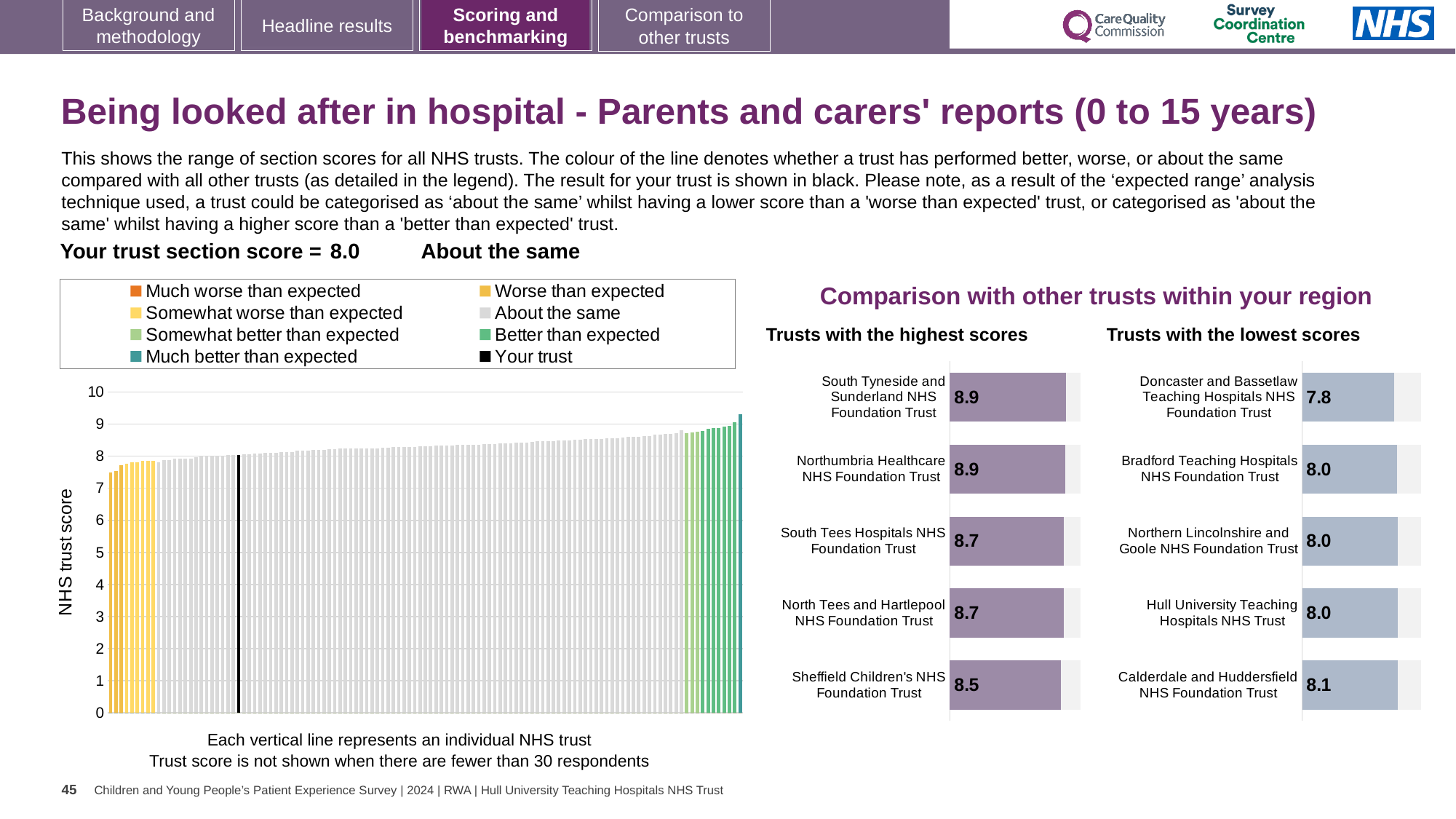
In the main chart on the left, do the trust scores rise or fall from left to right? Rise In the 'Trusts with the highest scores' chart, which trust has the lowest score? Sheffield Children's NHS Foundation Trust In the 'Trusts with the highest scores' chart, which has the higher score: South Tees Hospitals NHS Foundation Trust or Sheffield Children's NHS Foundation Trust? South Tees Hospitals NHS Foundation Trust How many entries does the legend of the main chart on the left list? 8 In the 'Trusts with the lowest scores' chart, which trust has the lowest score? Doncaster and Bassetlaw Teaching Hospitals NHS Foundation Trust In the 'Trusts with the highest scores' chart, what is the score for South Tees Hospitals NHS Foundation Trust? 8.7 How many trusts are shown in the 'Trusts with the highest scores' chart? 5 In the 'Trusts with the lowest scores' chart, which trust has the highest score? Calderdale and Huddersfield NHS Foundation Trust In the 'Trusts with the lowest scores' chart, how much higher is Calderdale and Huddersfield NHS Foundation Trust's score than Doncaster and Bassetlaw Teaching Hospitals NHS Foundation Trust's score? 0.3 In the 'Trusts with the lowest scores' chart, what is the score for Doncaster and Bassetlaw Teaching Hospitals NHS Foundation Trust? 7.8 In the 'Trusts with the highest scores' chart, what is the difference between the scores of South Tyneside and Sunderland NHS Foundation Trust and Sheffield Children's NHS Foundation Trust? 0.4 In the main chart on the left showing all NHS trusts, what is the section score for your trust? 8.0